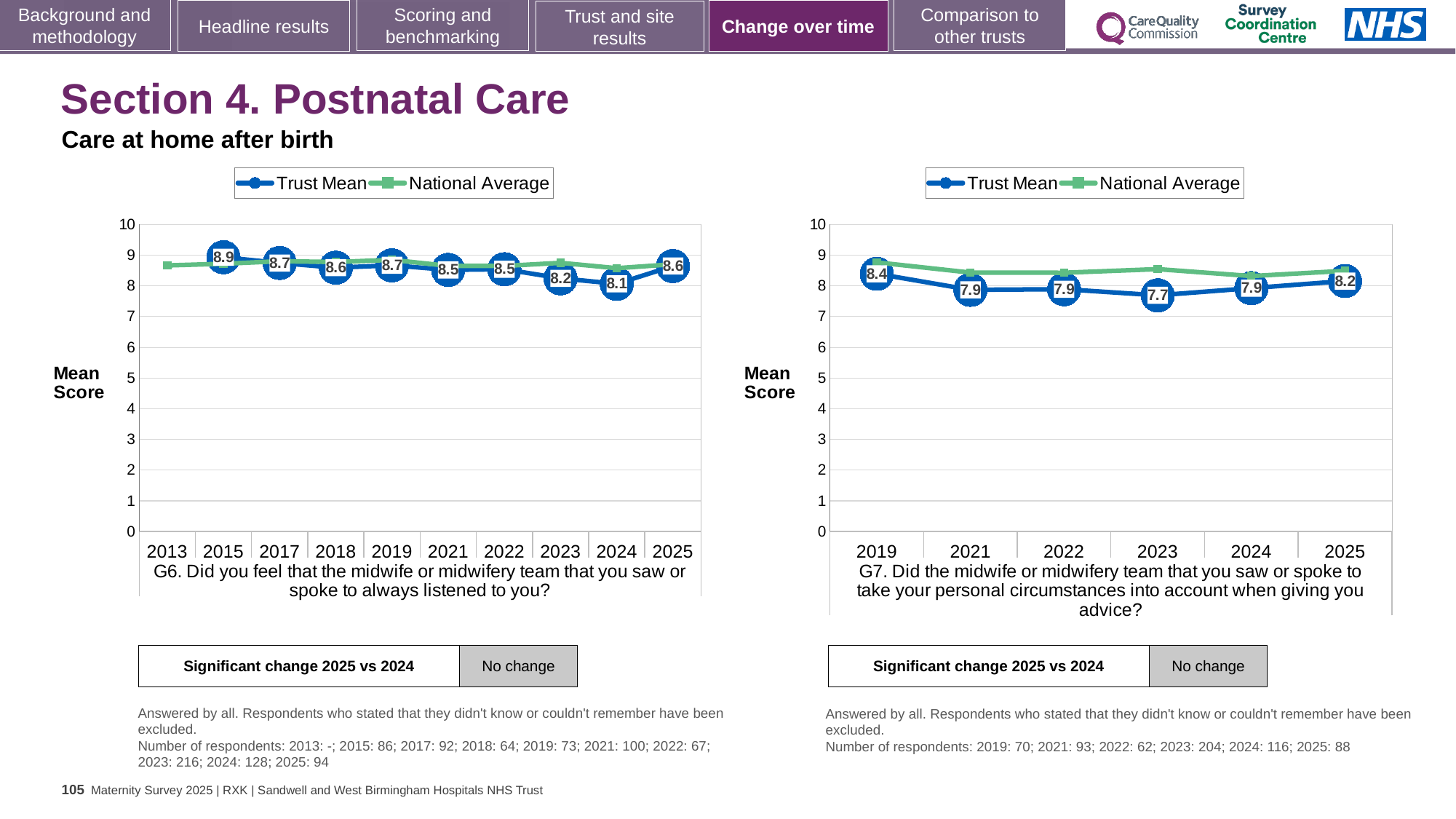
In the G7 chart on the right, what is the Trust Mean for 2023? 7.7 How many years are shown on the x axis of the G7 chart on the right? 6 In the G7 chart on the right, which year has the lowest Trust Mean? 2023 What kind of chart is the G6 chart on the left? Line chart In the G6 chart on the left, what is the Trust Mean for 2015? 8.9 How many series does the legend of the G6 chart on the left list? 2 In the G7 chart on the right, is the National Average for 2019 greater or less than 8? greater In the G6 chart on the left, which year has the highest Trust Mean? 2015 In the G7 chart on the right, which is larger: the Trust Mean for 2019 or the Trust Mean for 2025? 2019 In the G6 chart on the left, what is the Trust Mean for 2024? 8.1 In the G7 chart on the right, what is the Trust Mean for 2025? 8.2 In the G6 chart on the left, what is the difference between the Trust Mean for 2015 and the Trust Mean for 2024? 0.8